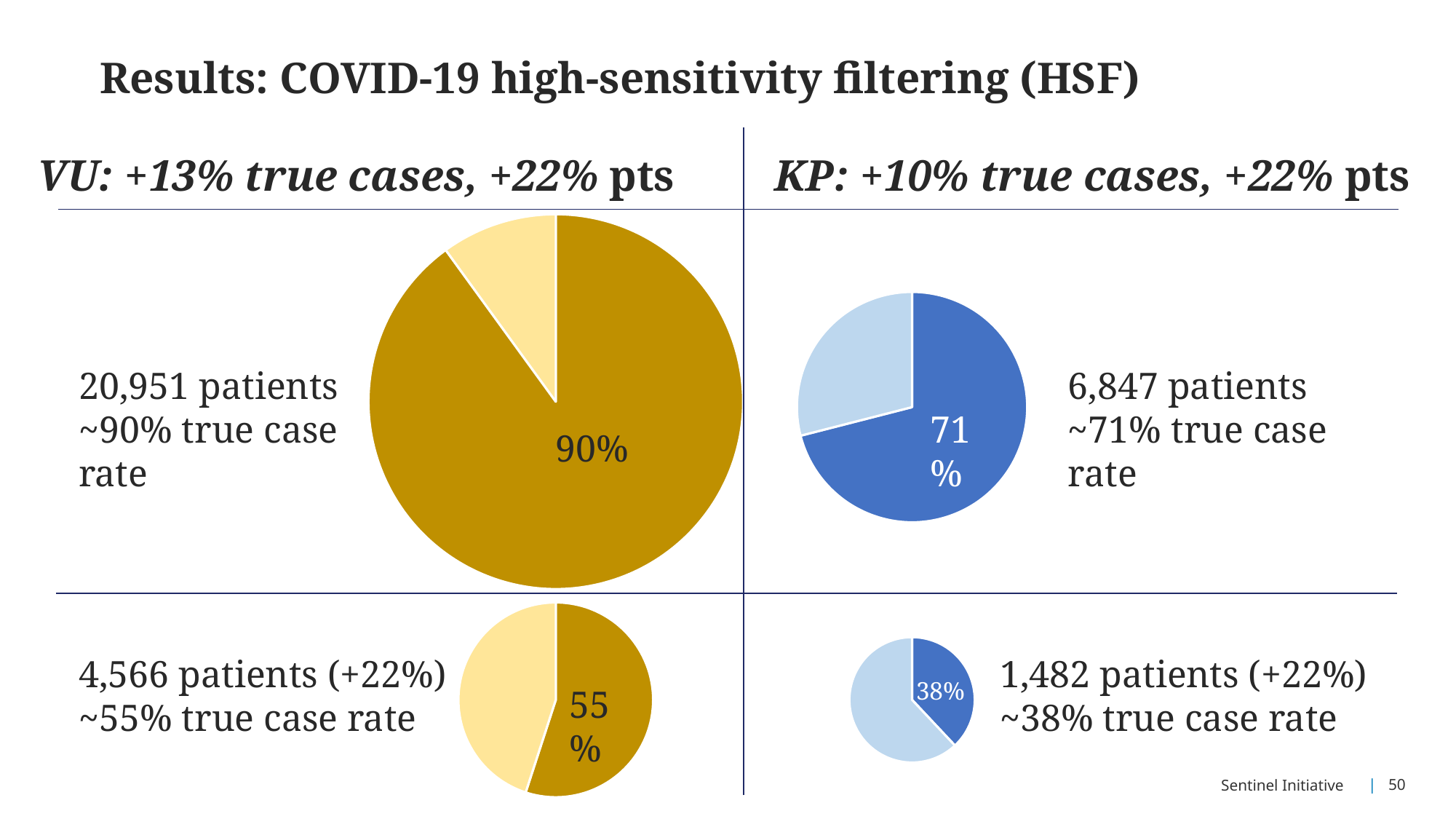
What is the difference between the labelled share in the top-left pie chart (90%) and the top-right pie chart (71%)? 19 percentage points What kind of chart is the top-left chart on the slide? Pie chart How many pie charts are shown on the slide? 4 In the bottom-left pie chart (4,566 patients), what percentage is printed on the dark slice? 55% Which pie chart shows a larger labelled share: the top-left chart or the top-right chart? Top-left (90%) How many slices does the top-left pie chart have? 2 What is the difference between the labelled share in the bottom-left pie chart (55%) and the bottom-right pie chart (38%)? 17 percentage points In the top-left pie chart, what share of the pie does the light yellow slice represent, given the dark slice is labelled 90%? 10% In the bottom-right pie chart (1,482 patients), what percentage is printed on the dark blue slice? 38% What colour is the larger slice in the top-right pie chart? Dark blue In the top-left pie chart (20,951 patients), what percentage is printed on the large dark slice? 90% In the top-right pie chart (6,847 patients), what percentage is printed on the dark blue slice? 71%